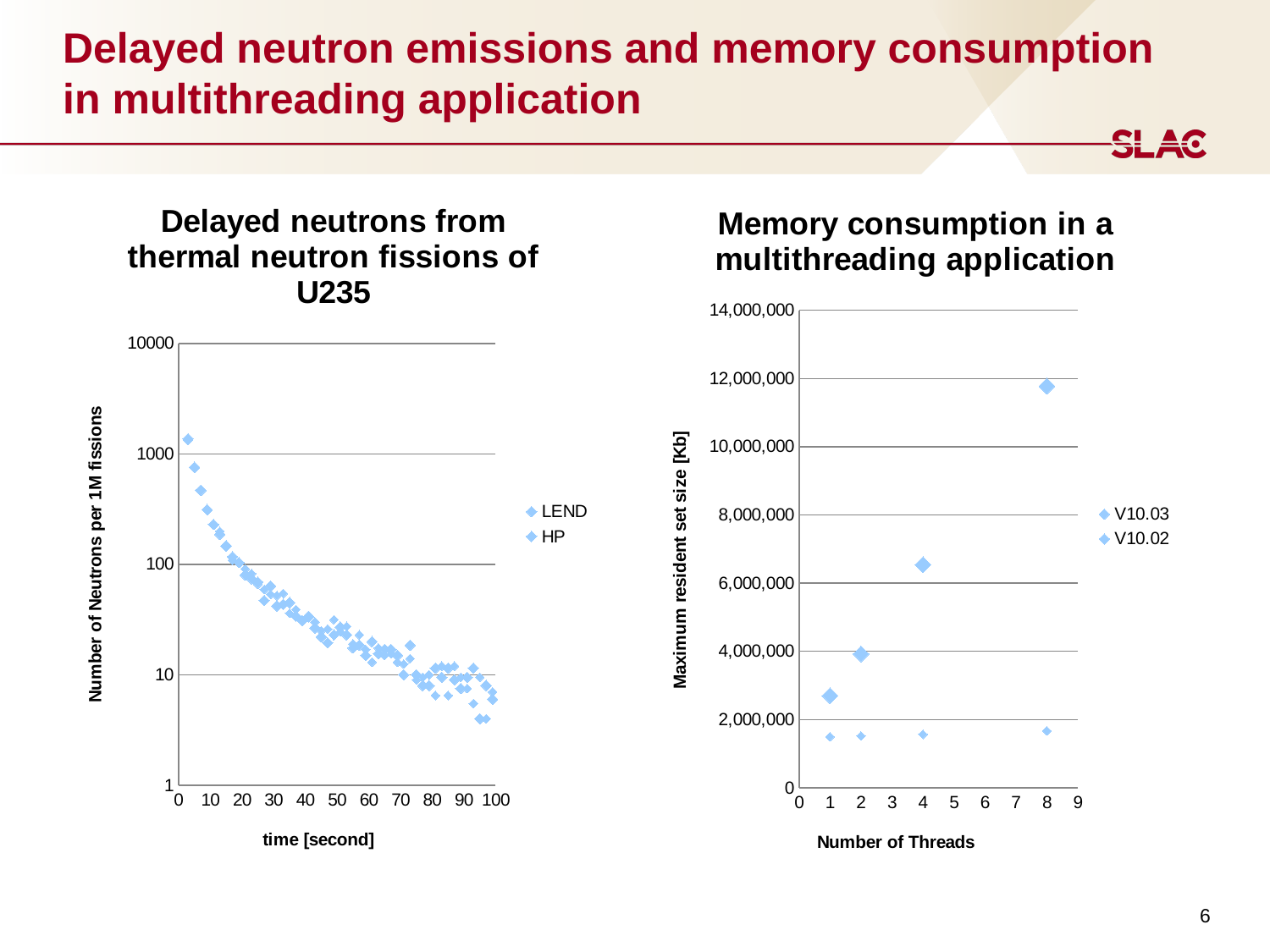
What is the x-axis title of the 'Memory consumption in a multithreading application' chart? Number of Threads In the 'Memory consumption in a multithreading application' chart, is the higher value at 4 threads greater or less than 6,000,000? greater In the 'Memory consumption in a multithreading application' chart, is the lower value at 8 threads greater or less than 2,000,000? less How many series does the legend of the 'Delayed neutrons from thermal neutron fissions of U235' chart list? 2 In the 'Memory consumption in a multithreading application' chart, at which number of threads is the highest maximum resident set size plotted? 8 What are the legend entries of the 'Delayed neutrons from thermal neutron fissions of U235' chart? LEND and HP How many series does the legend of the 'Memory consumption in a multithreading application' chart list? 2 What kind of chart is the 'Delayed neutrons from thermal neutron fissions of U235' chart? scatter chart In the 'Memory consumption in a multithreading application' chart, how many different thread counts have points plotted? 4 In the 'Delayed neutrons from thermal neutron fissions of U235' chart, do the values rise or fall as time increases? fall In the 'Memory consumption in a multithreading application' chart, is the higher value at 8 threads greater or less than 10,000,000? greater What kind of chart is the 'Memory consumption in a multithreading application' chart? scatter chart